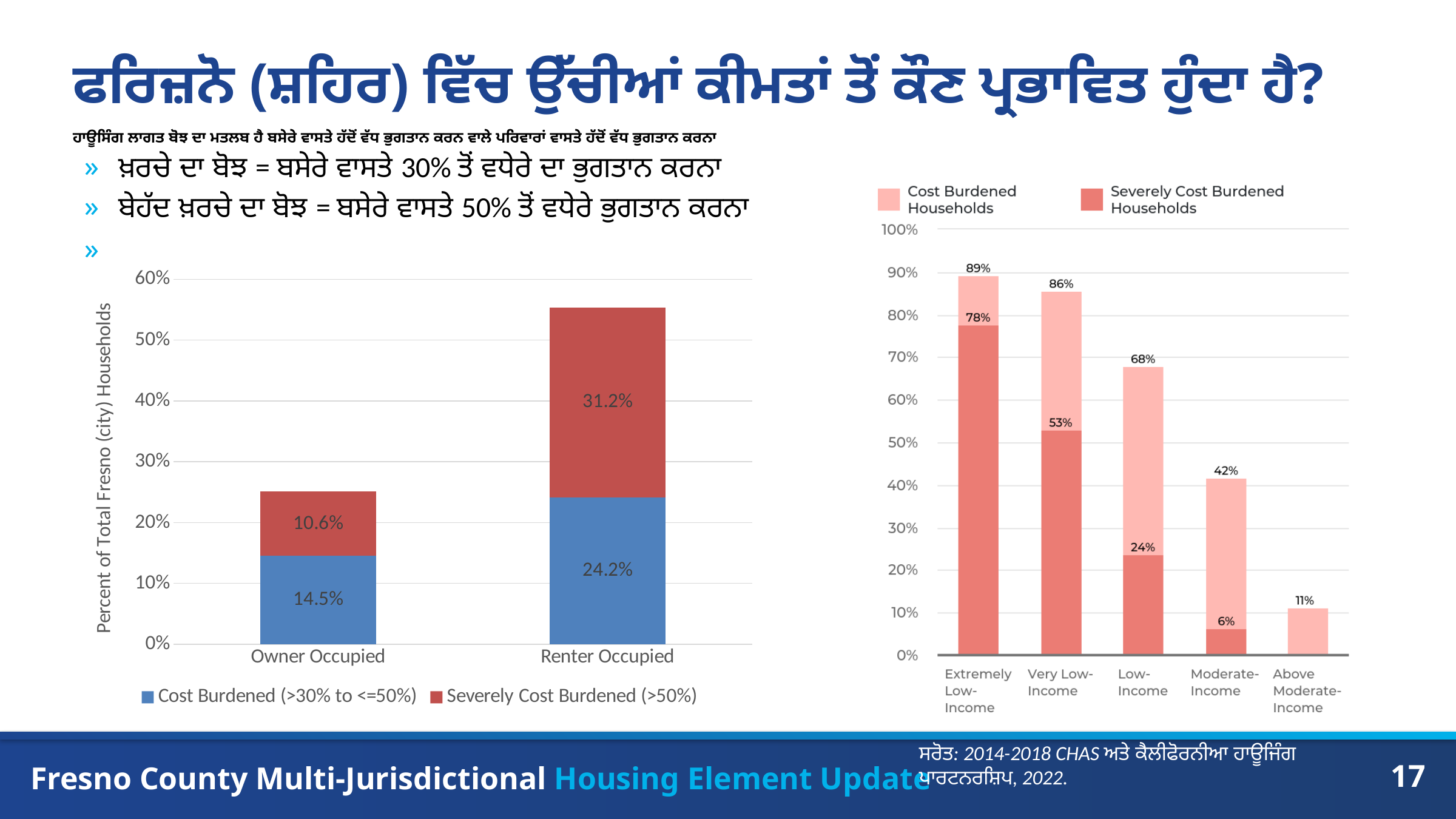
In the left chart, what is the total height of the Renter Occupied stacked bar? 55.4% In the right chart, which income category has the lowest total bar? Above Moderate-Income In the left chart, what is the Severely Cost Burdened (>50%) value for Renter Occupied households? 31.2% In the left chart, which category has the larger Cost Burdened (>30% to <=50%) value, Owner Occupied or Renter Occupied? Renter Occupied In the right chart, what is the Severely Cost Burdened Households value for Low-Income? 24% In the right chart, how many income categories are shown on the x axis? 5 What kind of chart is the chart on the right side of the slide? Stacked bar chart In the left chart, how many series does the legend list? 2 In the right chart, what is the total value shown above the Very Low-Income bar? 86% In the left chart, what is the difference between the Severely Cost Burdened values for Renter Occupied and Owner Occupied households? 20.6% In the right chart, do the total bar values rise or fall moving from Extremely Low-Income to Above Moderate-Income? Fall In the left chart, what is the Cost Burdened (>30% to <=50%) value for Owner Occupied households? 14.5%